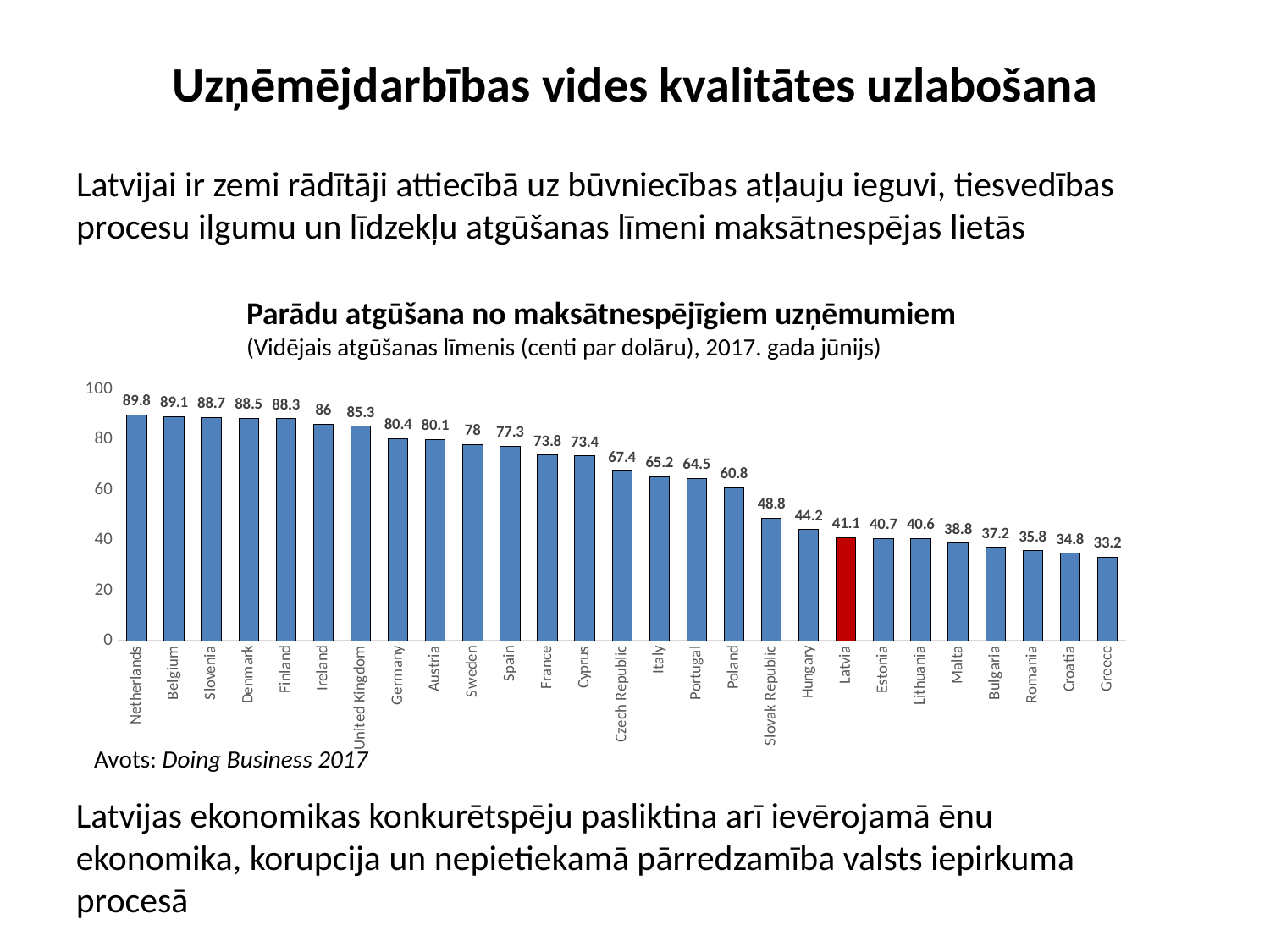
What is the difference between the values for Netherlands and Greece? 56.6 Which country has the lowest value in the chart? Greece Which has a larger value, Hungary or Estonia? Hungary Which country's bar is highlighted in red in the chart? Latvia Do the values rise or fall from left to right along the x axis? Fall What is the value for Germany in the chart? 80.4 What kind of chart is shown on the slide? Bar chart What is the value for Poland in the chart? 60.8 Which country has the highest value in the chart? Netherlands What is the difference between the values for Poland and Slovak Republic? 12 What is the value for Latvia in the chart? 41.1 How many countries are shown in the chart? 27